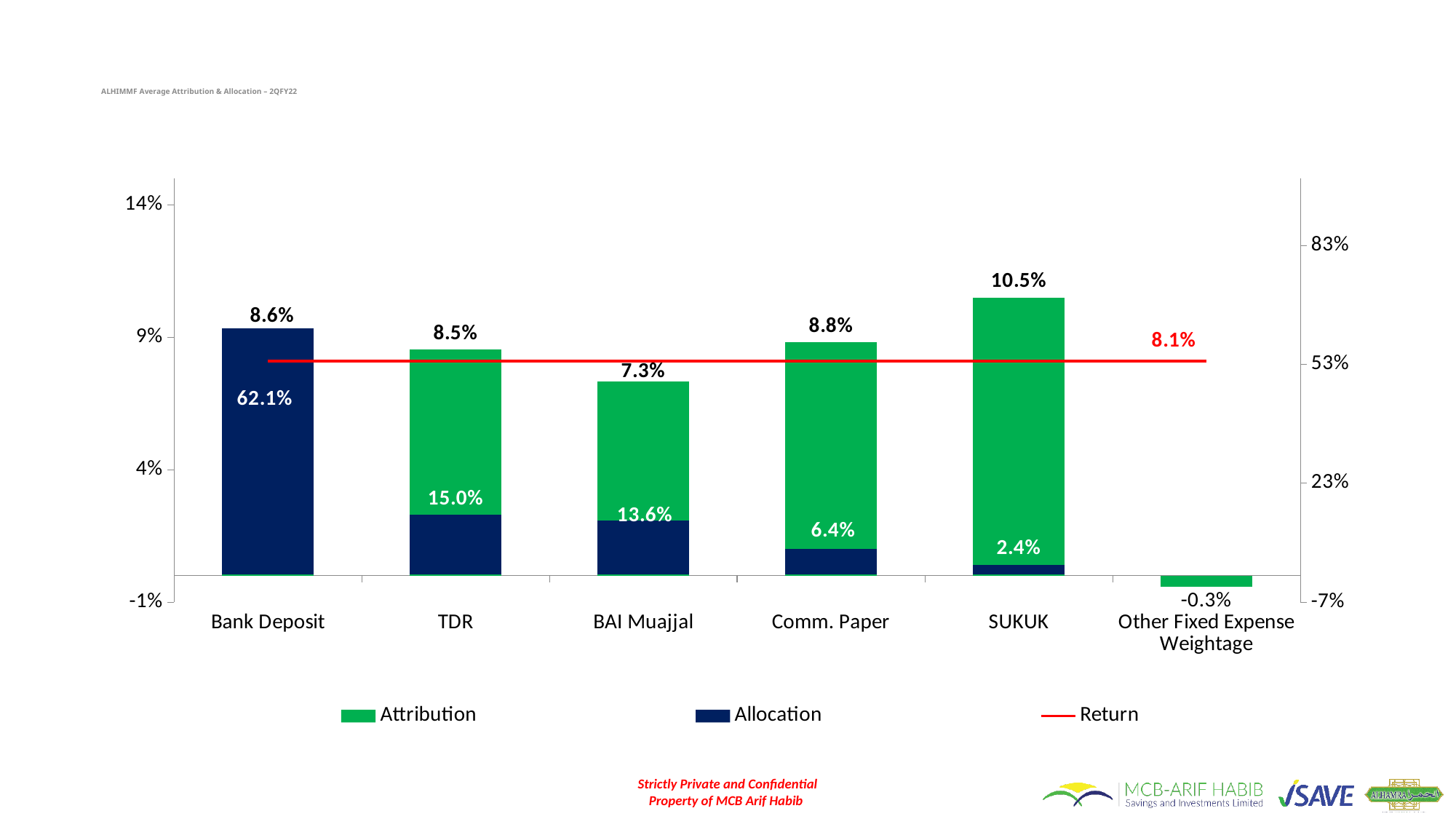
Which category has the lowest Allocation value among those labelled? SUKUK What is the Allocation value for Bank Deposit? 62.1% Which has a larger Allocation value, TDR or BAI Muajjal? TDR What is the Allocation value for Comm. Paper? 6.4% What is the Attribution value for SUKUK? 10.5% What is the Attribution value for BAI Muajjal? 7.3% How many series does the legend list? 3 What is the difference between the Attribution values for SUKUK and BAI Muajjal? 3.2% How many categories are shown on the x axis? 6 Which category has the highest Attribution value? SUKUK What is the Return value shown on the chart? 8.1% What is the title of the chart? ALHIMMF Average Attribution & Allocation – 2QFY22